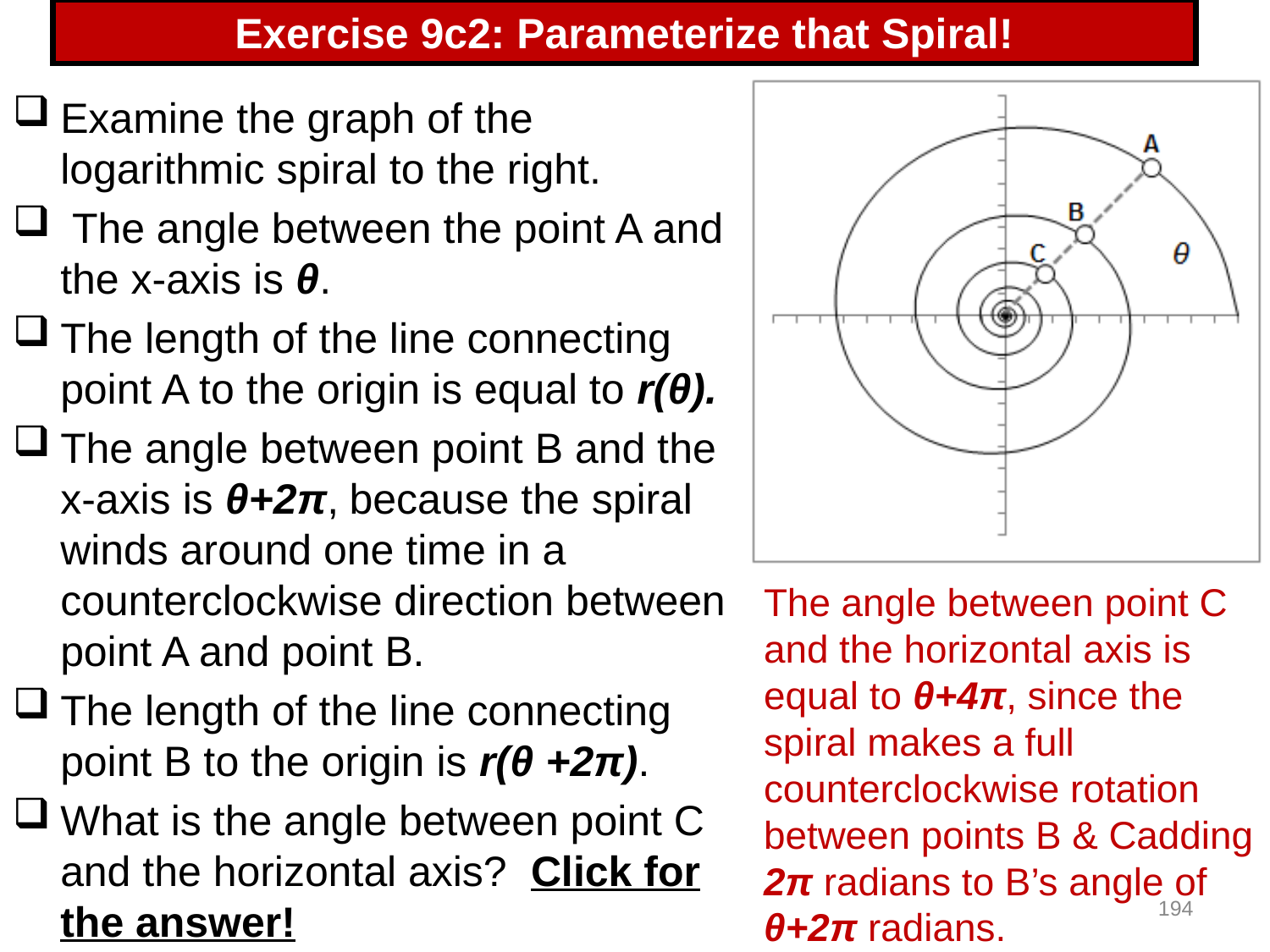
Which point is farther from the origin, A or B? A What symbol labels the angle shown in the graph? θ In which direction does the spiral wind as it moves outward from point C to point A? Counterclockwise How many labeled points are marked on the spiral in the graph? 3 Which labeled point on the spiral is closest to the origin? C Which labeled point on the spiral is farthest from the origin? A What are the labels of the three points marked on the spiral? A, B, C What kind of curve is plotted in the graph? A logarithmic spiral Which point is farther from the origin, B or C? B Which labeled point lies between A and C along the dashed line from the origin? B